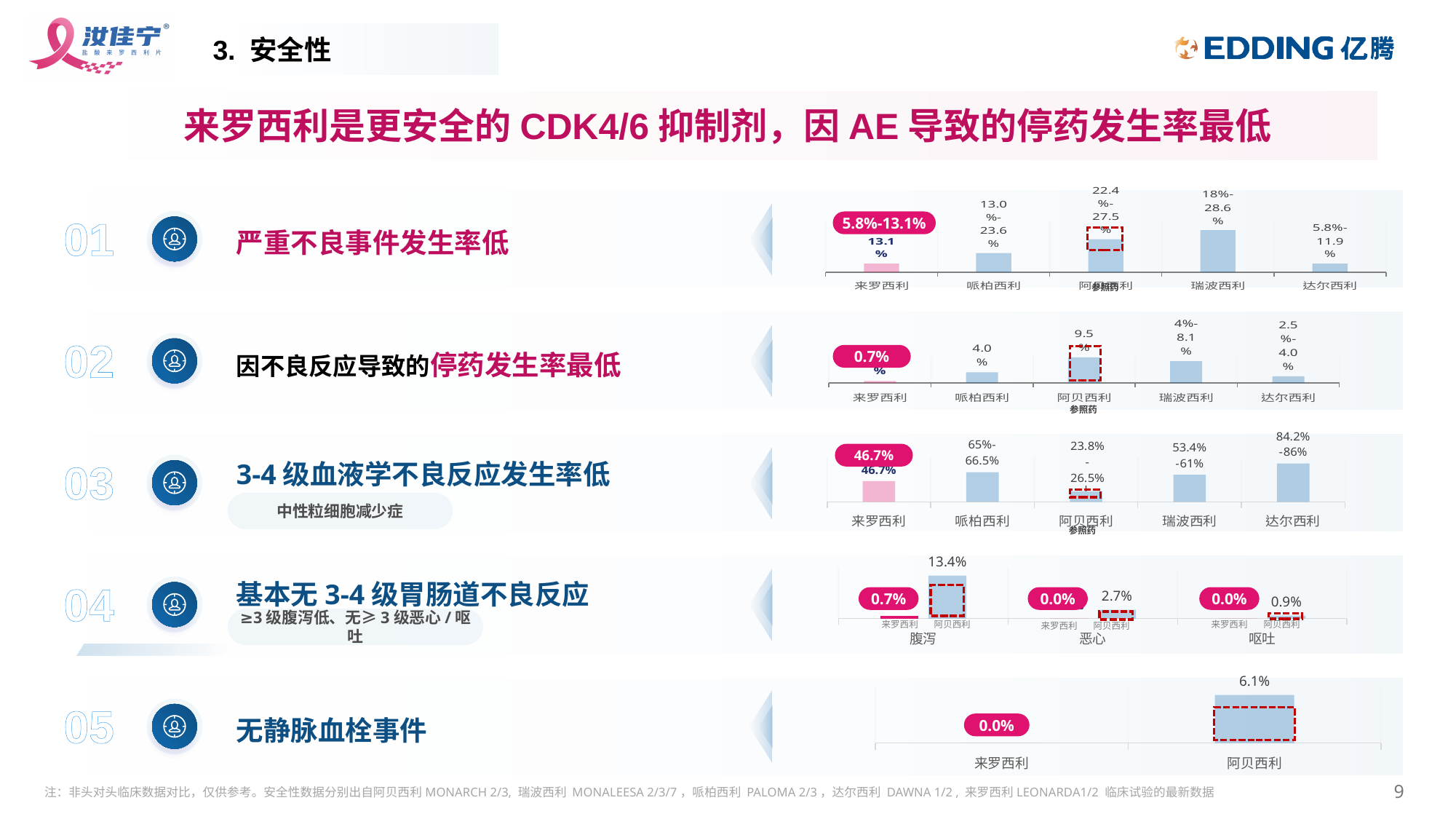
In the chart next to item 02 (因不良反应导致的停药发生率最低), which drug has the highest value? 阿贝西利 In the chart next to item 02 (因不良反应导致的停药发生率最低), what is the value for 哌柏西利? 4.0% In the chart next to item 02 (因不良反应导致的停药发生率最低), which drug has the lowest value? 来罗西利 In the chart next to item 04 (基本无 3-4 级胃肠道不良反应), what is the 腹泻 value for 阿贝西利? 13.4% In the chart next to item 02 (因不良反应导致的停药发生率最低), what is the value for 来罗西利? 0.7% In the chart next to item 05 (无静脉血栓事件), what is the value for 阿贝西利? 6.1% In the chart next to item 04 (基本无 3-4 级胃肠道不良反应), what is the 呕吐 value for 阿贝西利? 0.9% In the chart next to item 01 (严重不良事件发生率低), how many drugs are shown on the x axis? 5 In the chart next to item 03 (3-4 级血液学不良反应发生率低), which drug has the highest bar? 达尔西利 What type of chart is shown next to item 05 (无静脉血栓事件)? Bar chart In the chart next to item 03 (3-4 级血液学不良反应发生率低), what is the value for 来罗西利? 46.7% In the chart next to item 04 (基本无 3-4 级胃肠道不良反应), what is the difference between the 腹泻 values for 阿贝西利 and 来罗西利? 12.7%